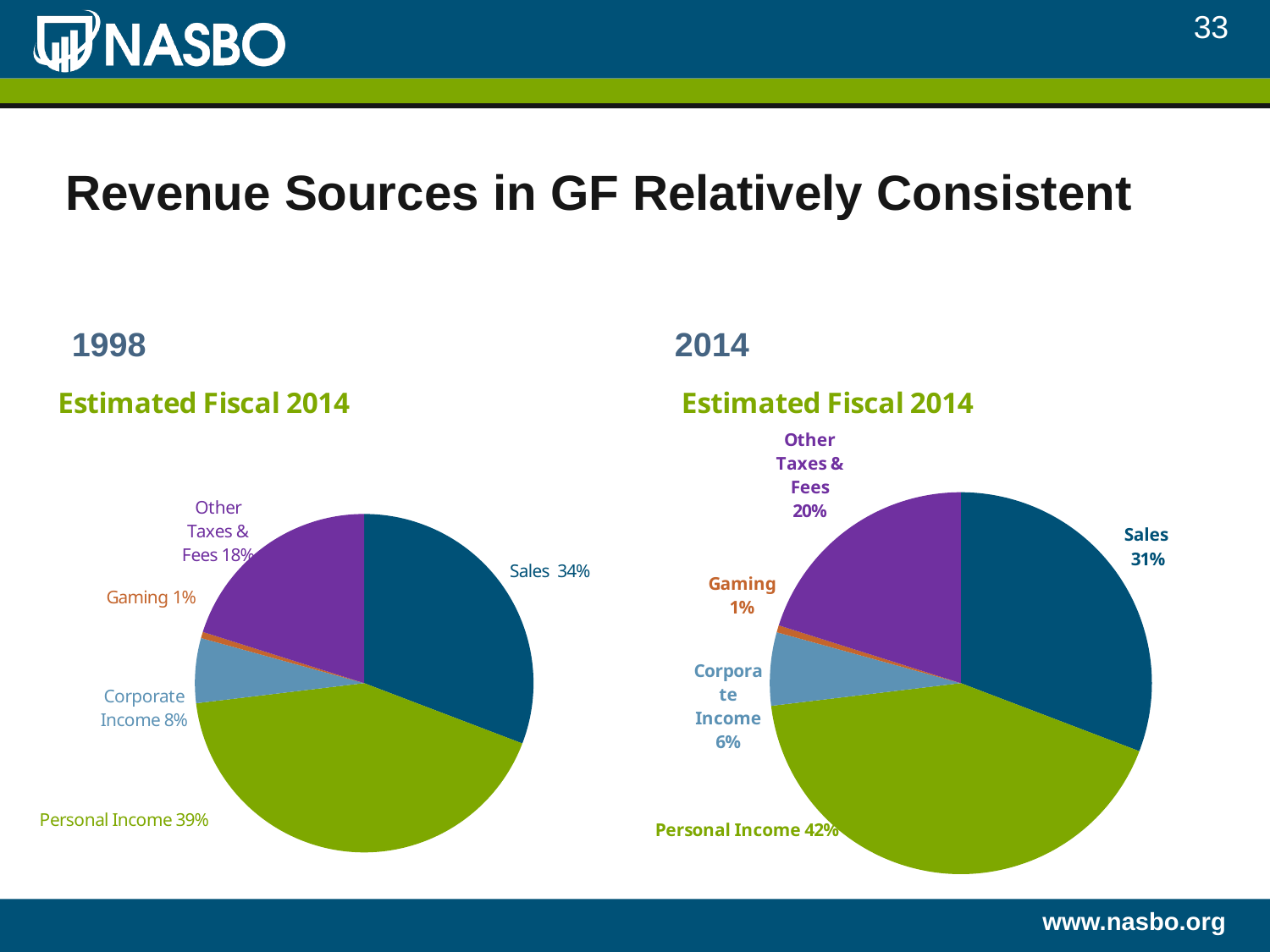
What type of chart is used on this slide? Pie chart What colour is the Personal Income slice in both pie charts? Green In the left pie chart (1998), what is the difference between the Other Taxes & Fees share and the Corporate Income share? 10% In the right pie chart (2014), what share does Other Taxes & Fees have? 20% In the left pie chart (1998), what share does Sales have? 34% In the right pie chart (2014), which category has the smallest share? Gaming In the left pie chart (1998), what share does Corporate Income have? 8% How many categories does the right pie chart (2014) show? 5 Which is larger: the Sales share in the left pie chart (1998) or the Sales share in the right pie chart (2014)? 1998 (34%) In the right pie chart (2014), what is the difference between the Personal Income share and the Sales share? 11% In the left pie chart (1998), which category has the largest share? Personal Income In the right pie chart (2014), what share does Personal Income have? 42%